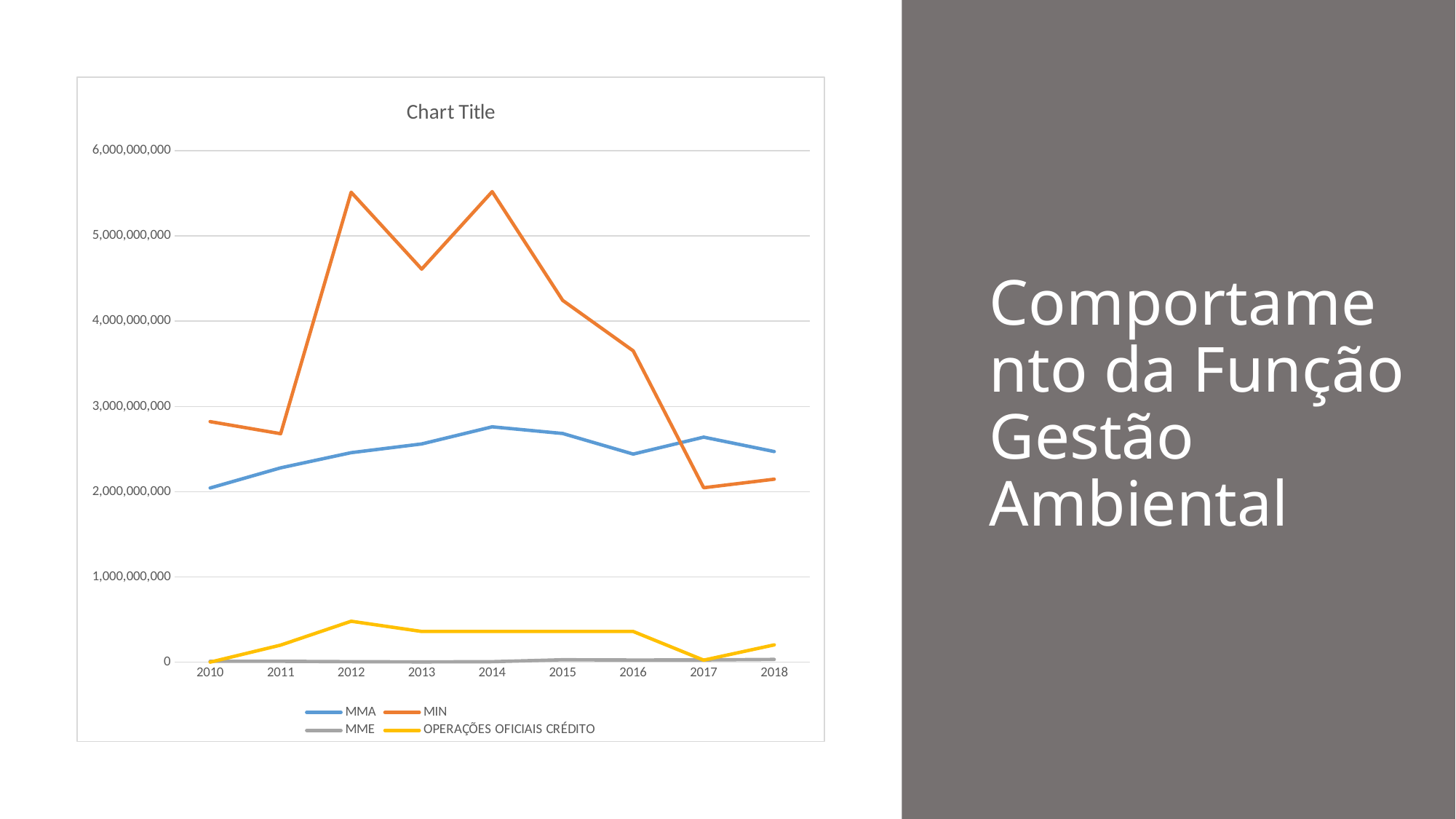
Is the value for MIN in 2016 greater or less than 4,000,000,000? less What kind of chart is shown on the slide? Line chart Is the value for OPERAÇÕES OFICIAIS CRÉDITO in 2012 greater or less than 1,000,000,000? less In 2017, which series has the larger value, MMA or MIN? MMA Is the value for MIN in 2012 greater or less than 5,000,000,000? greater How many years are plotted along the x axis of the chart? 9 How many series does the chart legend list? 4 In which year does the MMA series reach its lowest value? 2010 Does the MIN series rise or fall from 2014 to 2017? Fall What is the title shown above the chart? Chart Title In 2012, which series has the larger value, MIN or MMA? MIN